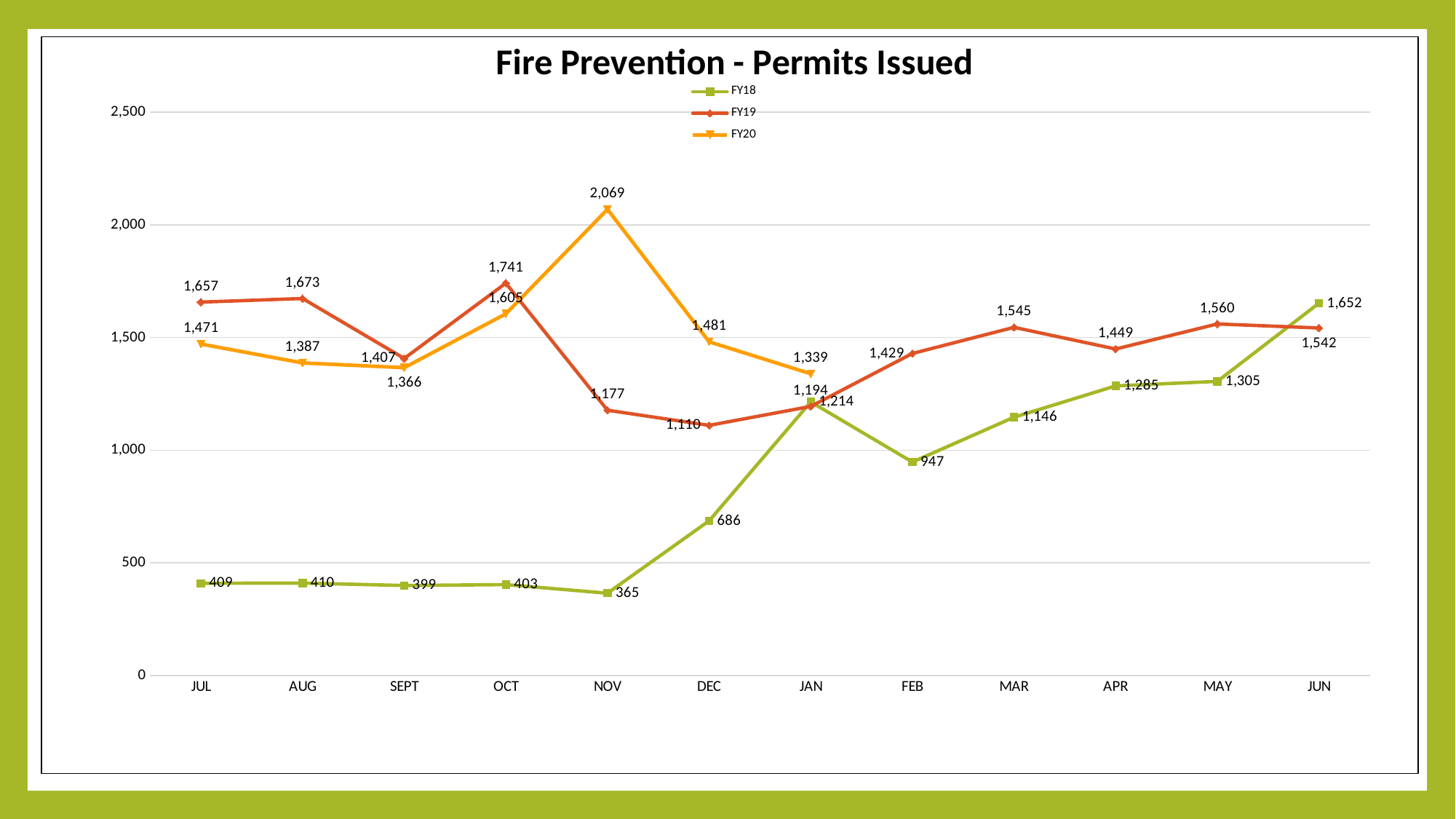
How many series does the legend list? 3 What kind of chart is this? line chart Is the FY18 value for DEC greater or less than 500? greater Which is larger in JUN, the FY18 value or the FY19 value? FY18 In which month is the FY19 series highest? OCT In which month is the FY18 series lowest? NOV What is the FY20 value for NOV? 2,069 Does the FY18 series rise or fall from DEC to JAN? rise What is the FY19 value for OCT? 1,741 What is the FY18 value for FEB? 947 How many months are shown on the x axis? 12 What is the difference between the FY20 and FY19 values for NOV? 892